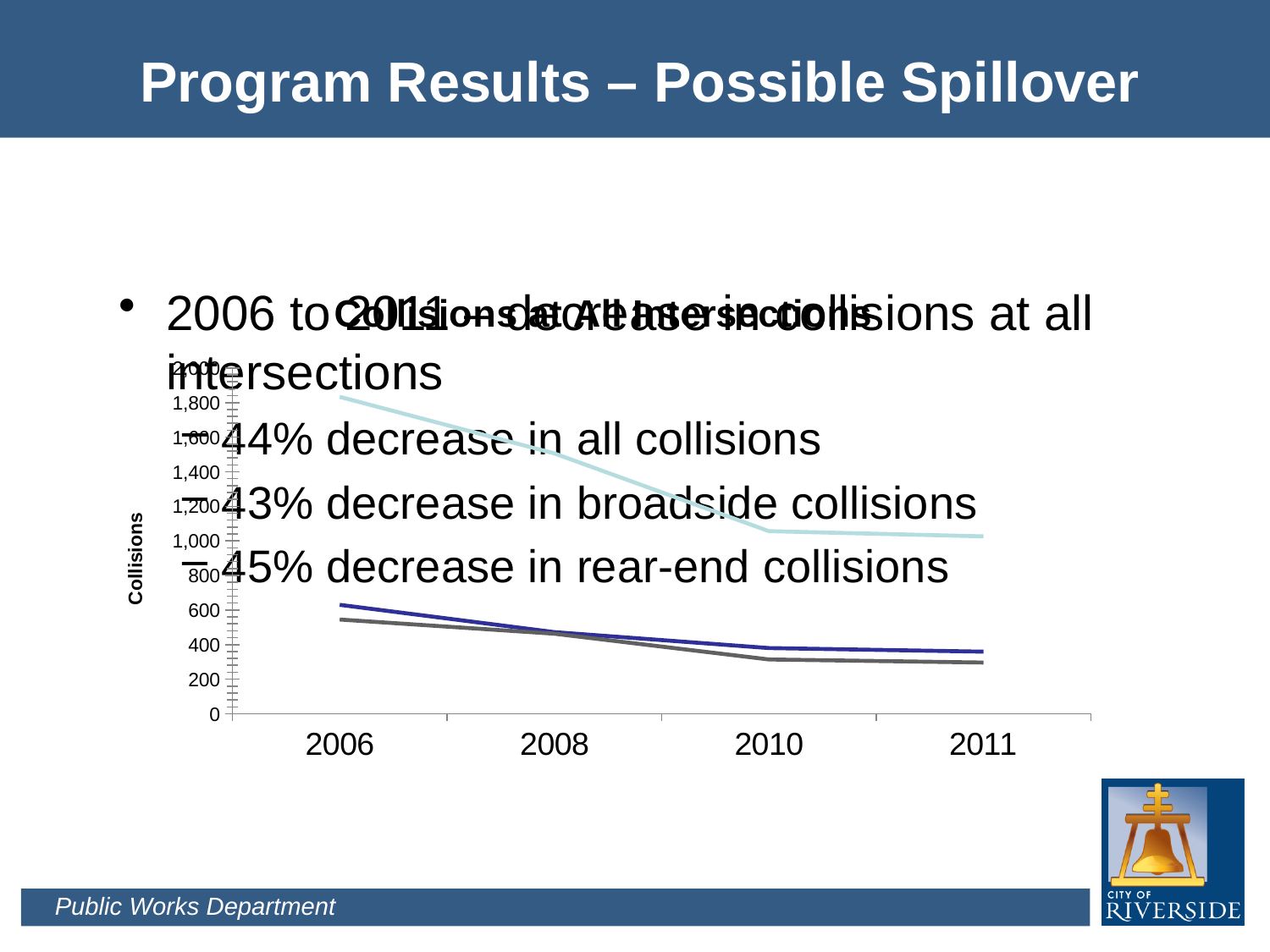
In 2006, which line has the larger value, the light blue line or the dark blue line? the light blue line Do the values of the gray line rise or fall from 2006 to 2011? fall Is the value of the dark blue line in 2006 greater or less than 400? greater Do the values of the top (light blue) line rise or fall from 2006 to 2011? fall What kind of chart is shown on the slide? line chart Is the value of the top (light blue) line in 2006 greater or less than 1,600? greater Is the value of the gray line in 2011 greater or less than 400? less What is the title of the chart? Collisions at All Intersections How many years are marked on the x axis of the chart? 4 In which year does the top (light blue) line reach its highest value? 2006 What is the label on the y axis of the chart? Collisions